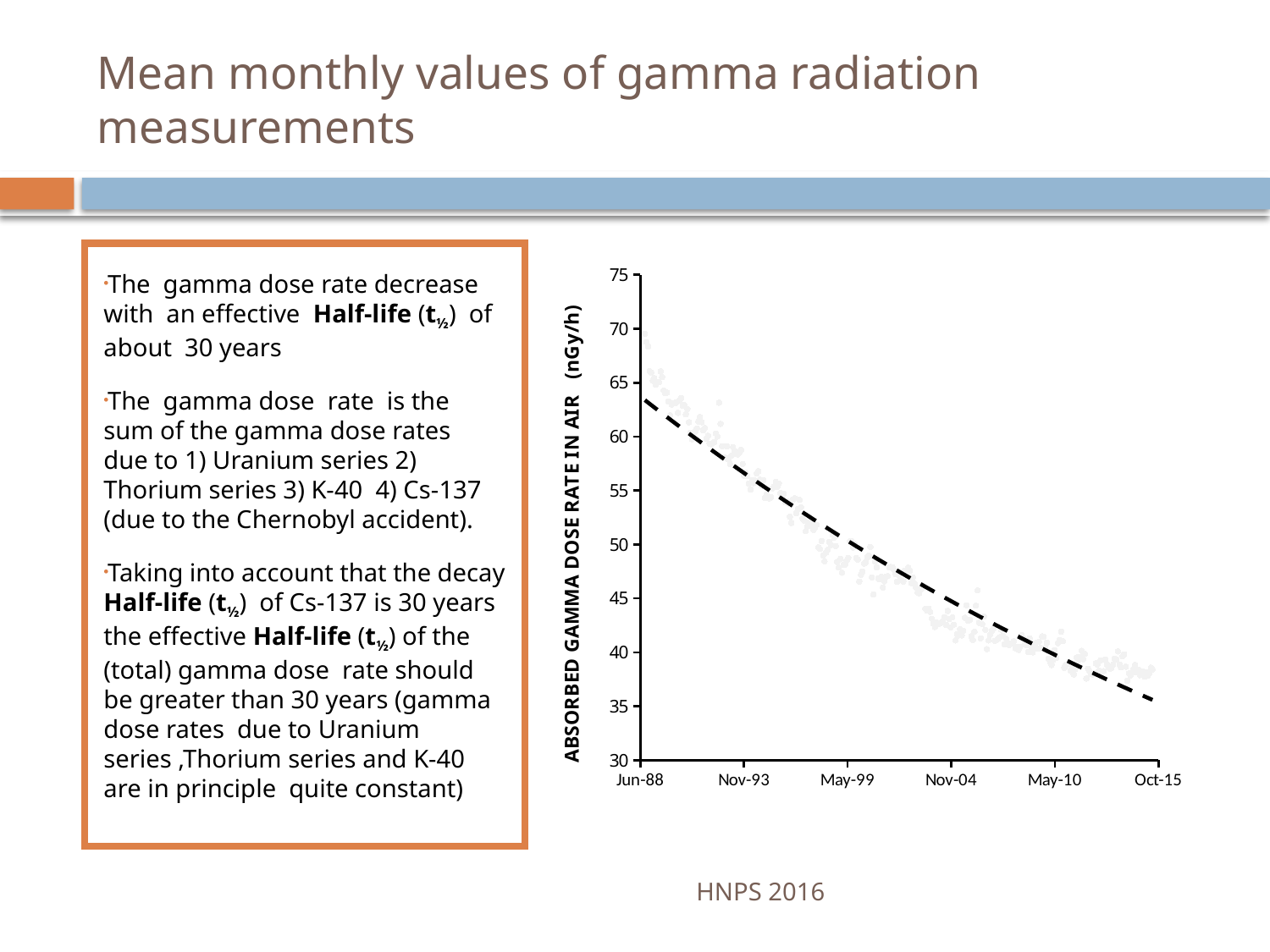
What kind of chart is shown on the slide? scatter chart Is the absorbed gamma dose rate at Jun-88 greater or less than 60 nGy/h? greater Is the absorbed gamma dose rate around Nov-93 greater or less than 50 nGy/h? greater Is the absorbed gamma dose rate around Nov-04 greater or less than 50 nGy/h? less Which is larger, the absorbed gamma dose rate at Jun-88 or at Oct-15? Jun-88 What is the highest value shown on the y axis of the chart? 75 How many date labels are shown on the x axis of the chart? 6 What is the title of the y axis of the chart? ABSORBED GAMMA DOSE RATE IN AIR (nGy/h) Do the absorbed gamma dose rate values rise or fall from Jun-88 to Oct-15? fall